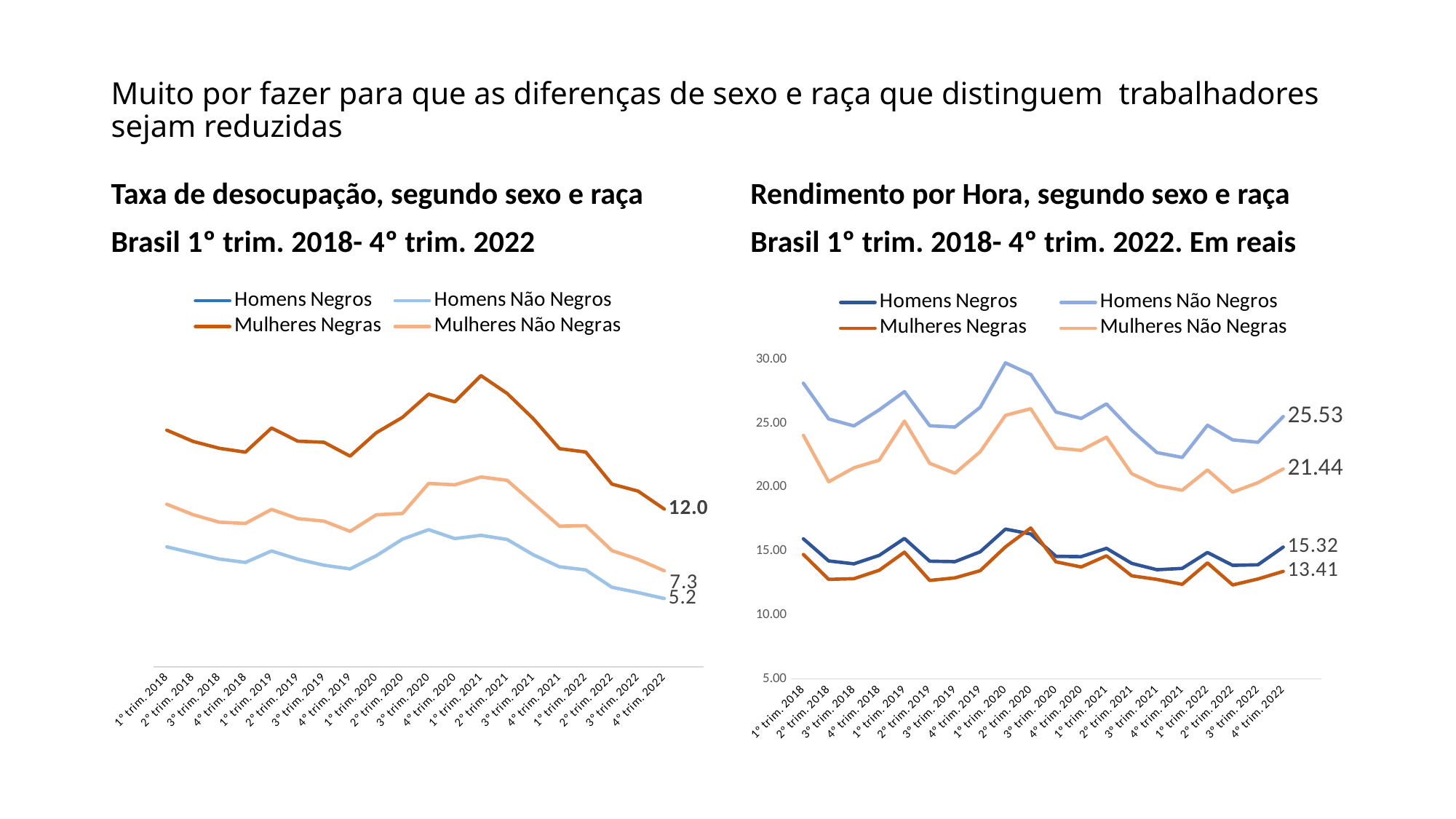
How many series does the legend of the right chart 'Rendimento por Hora, segundo sexo e raça' list? 4 In the right chart 'Rendimento por Hora, segundo sexo e raça', is the value for Mulheres Negras in 4° trim. 2021 greater or less than 15.00? less In the right chart 'Rendimento por Hora, segundo sexo e raça', what is the difference between the 4° trim. 2022 values for Homens Não Negros and Mulheres Não Negras? 4.09 In the right chart 'Rendimento por Hora, segundo sexo e raça', what is the value for Mulheres Negras in 4° trim. 2022? 13.41 In the right chart 'Rendimento por Hora, segundo sexo e raça', what is the value for Homens Não Negros in 4° trim. 2022? 25.53 In the left chart 'Taxa de desocupação, segundo sexo e raça', what is the value for Homens Não Negros in 4° trim. 2022? 5.2 In the left chart 'Taxa de desocupação, segundo sexo e raça', what is the value for Mulheres Negras in 4° trim. 2022? 12.0 In the right chart 'Rendimento por Hora, segundo sexo e raça', which series has the highest value in 4° trim. 2022? Homens Não Negros In the right chart 'Rendimento por Hora, segundo sexo e raça', which is larger in 4° trim. 2022: Homens Negros or Mulheres Negras? Homens Negros In the left chart 'Taxa de desocupação, segundo sexo e raça', what is the difference between the 4° trim. 2022 values for Mulheres Negras and Mulheres Não Negras? 4.7 What kind of chart is the left chart, 'Taxa de desocupação, segundo sexo e raça'? line chart In the right chart 'Rendimento por Hora, segundo sexo e raça', is the value for Homens Não Negros in 1° trim. 2020 greater or less than 25.00? greater